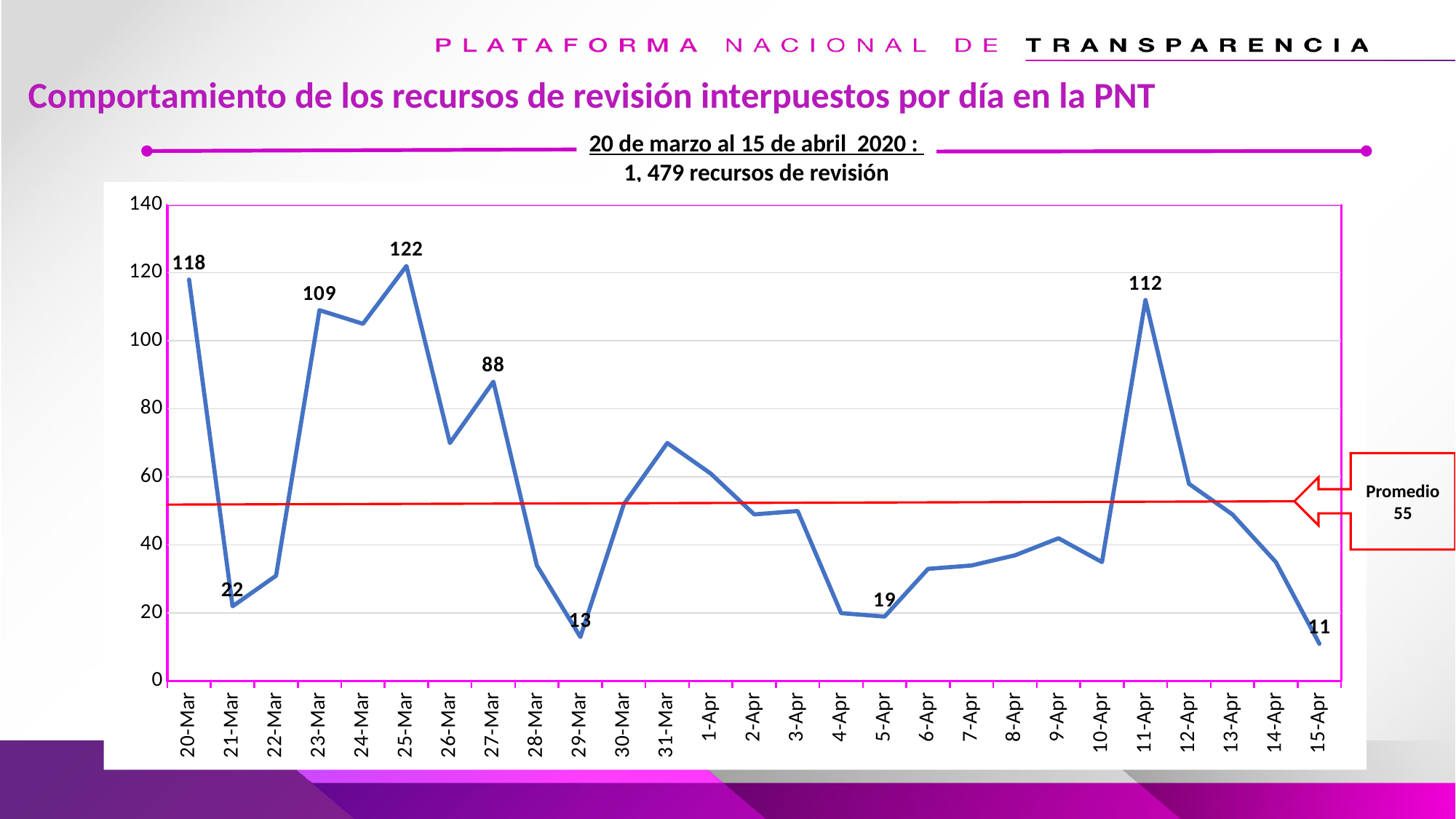
Which date has the lowest value? 15-Apr What is the value for 25-Mar? 122 What is the difference between the values for 25-Mar and 20-Mar? 4 What is the value for 11-Apr? 112 What is the value for 29-Mar? 13 Is the value for 31-Mar greater or less than 60? greater What average value (Promedio) is indicated by the red horizontal line? 55 Which is larger, the value for 23-Mar or the value for 27-Mar? 23-Mar Which date has the highest value? 25-Mar How many dates are plotted on the x axis? 27 What is the value for 20-Mar? 118 What type of chart is shown on the slide? line chart